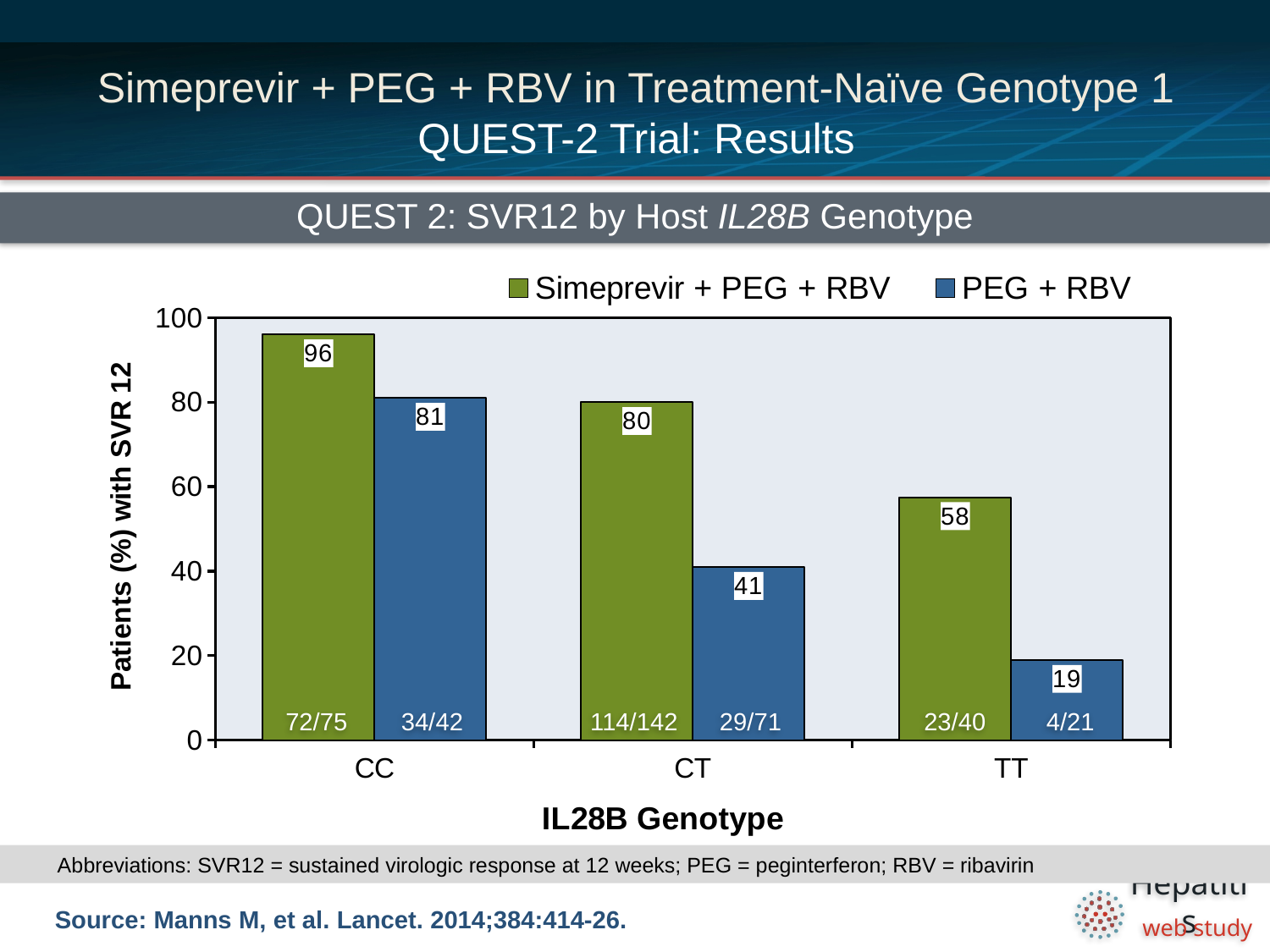
How many IL28B genotype categories are shown on the x axis? 3 What fraction of patients is printed at the base of the PEG + RBV bar for the TT genotype? 4/21 What is the SVR12 rate for Simeprevir + PEG + RBV in the CC genotype group? 96 What kind of chart is shown on the slide? Bar chart What is the difference between the Simeprevir + PEG + RBV and PEG + RBV SVR12 rates in the CT genotype group? 39 What is the SVR12 rate for PEG + RBV in the TT genotype group? 19 Do the Simeprevir + PEG + RBV SVR12 rates rise or fall from CC to TT along the x axis? Fall How many series does the legend list? 2 Which genotype has the highest SVR12 rate for Simeprevir + PEG + RBV? CC Which genotype has the lowest SVR12 rate for PEG + RBV? TT Which is larger: the SVR12 rate for Simeprevir + PEG + RBV in the TT group or for PEG + RBV in the CC group? PEG + RBV in the CC group What is the SVR12 rate for PEG + RBV in the CT genotype group? 41